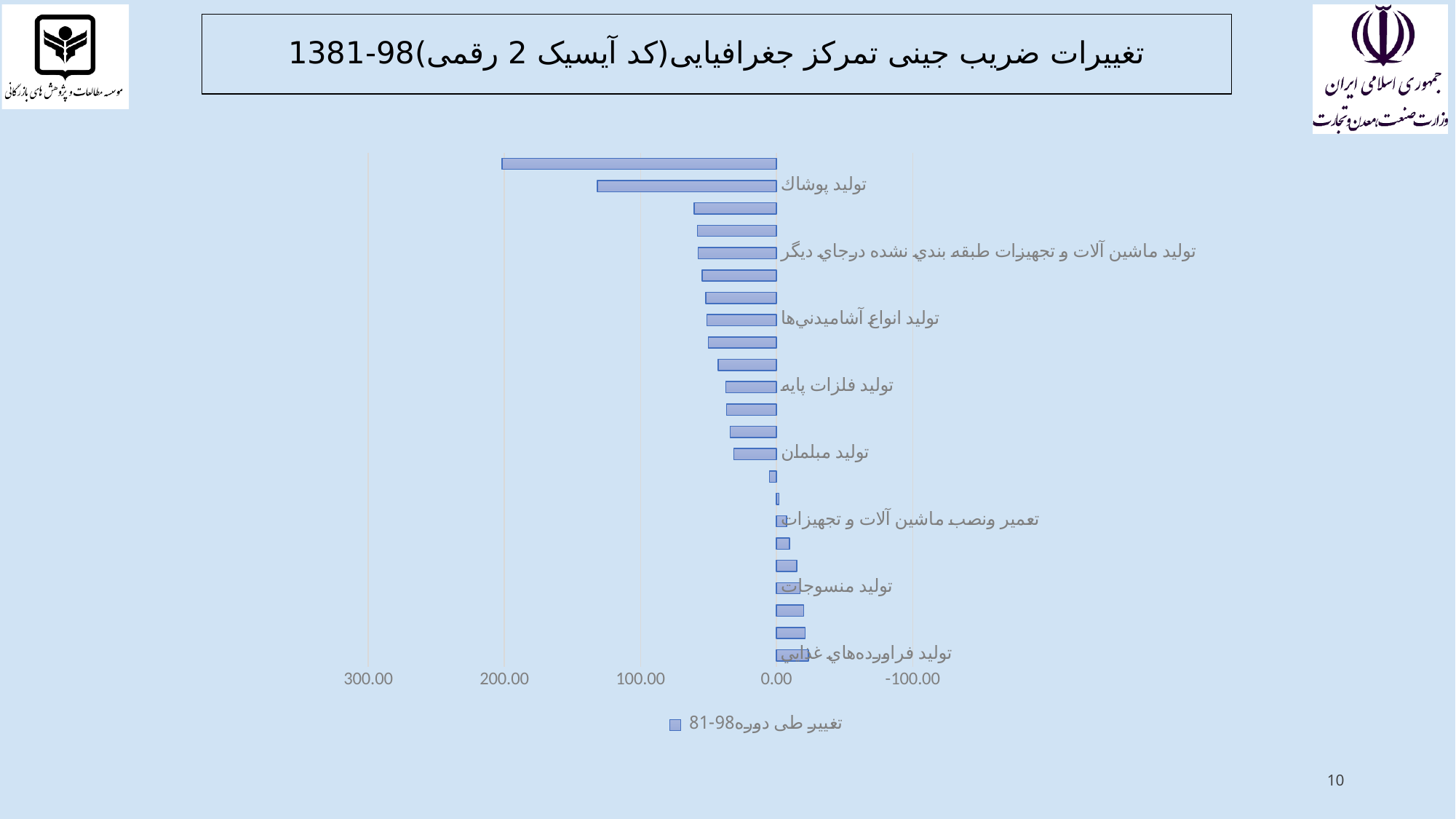
Which has the larger value, تولید پوشاک or تولید مبلمان? تولید پوشاک Is the value for تولید پوشاک greater or less than 100? greater Is the value for تولید فلزات پایه greater or less than 100? less What is the legend entry of the series plotted in the chart? تغییر طی دوره 81-98 Which has the larger value, تولید ماشین آلات و تجهیزات طبقه بندی نشده درجای دیگر or تولید فلزات پایه? تولید ماشین آلات و تجهیزات طبقه بندی نشده درجای دیگر Is the value for تولید منسوجات greater or less than 0? less How many series does the legend list? 1 What kind of chart is shown on the slide? bar chart What is the largest value shown on the horizontal axis? 300.00